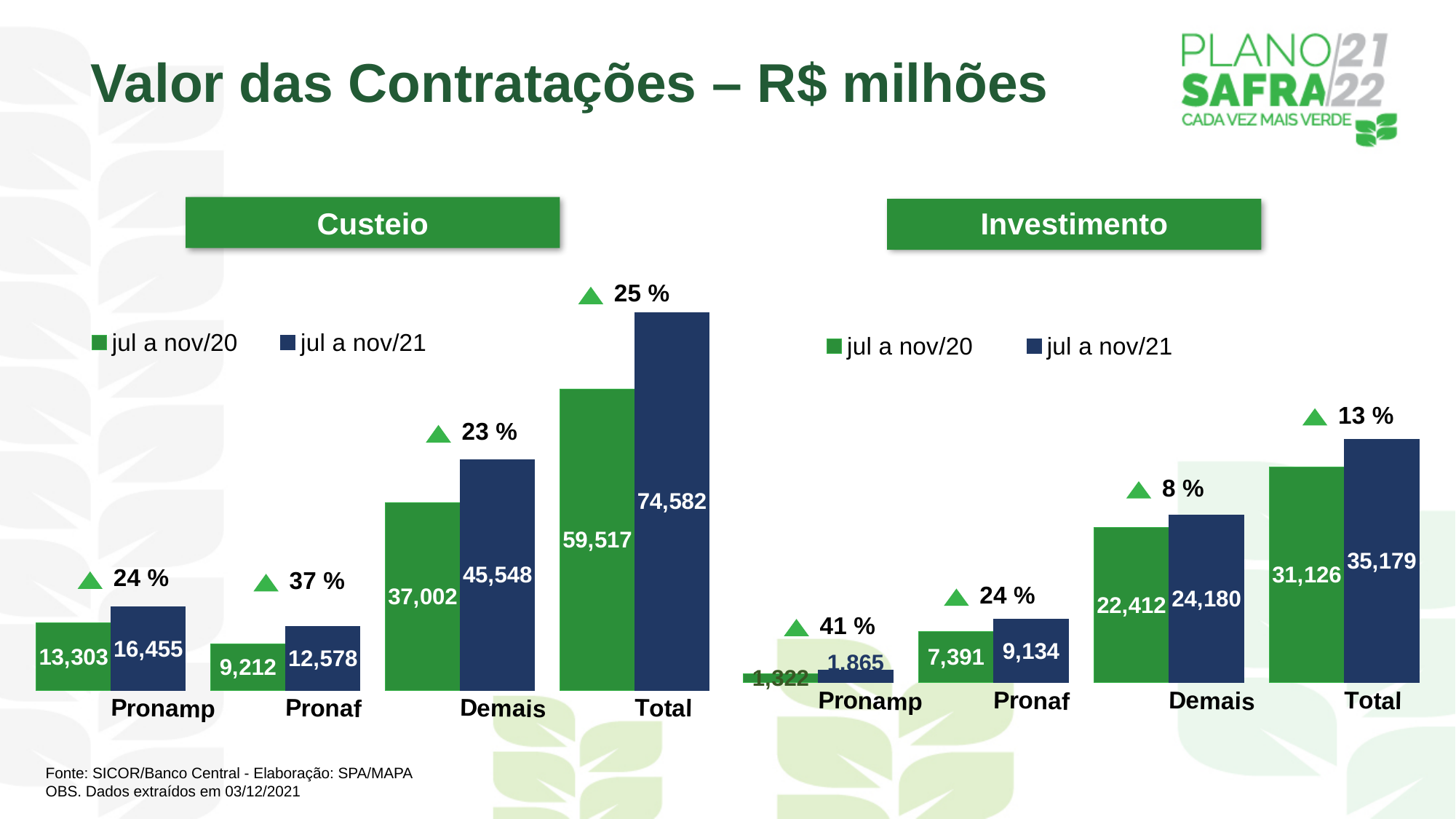
In the Custeio chart, what is the value for Demais in jul a nov/21? 45,548 In the Custeio chart, which is larger: Pronaf in jul a nov/21 or Pronamp in jul a nov/20? Pronamp in jul a nov/20 In the Custeio chart, what is the difference between the Total values for jul a nov/21 and jul a nov/20? 15,065 In the Investimento chart, what percentage change is shown above the Pronamp bars? 41 % In the Custeio chart, what is the value for Pronamp in jul a nov/20? 13,303 How many series does the legend of the Custeio chart list? 2 In the Investimento chart, what is the difference between the Demais values for jul a nov/21 and jul a nov/20? 1,768 How many categories are shown on the x axis of the Investimento chart? 4 In the Investimento chart, which category has the lowest value in jul a nov/21? Pronamp What kind of chart is the Investimento chart? Bar chart In the Custeio chart, excluding Total, which category has the highest value in jul a nov/21? Demais In the Investimento chart, what is the value for Pronaf in jul a nov/20? 7,391